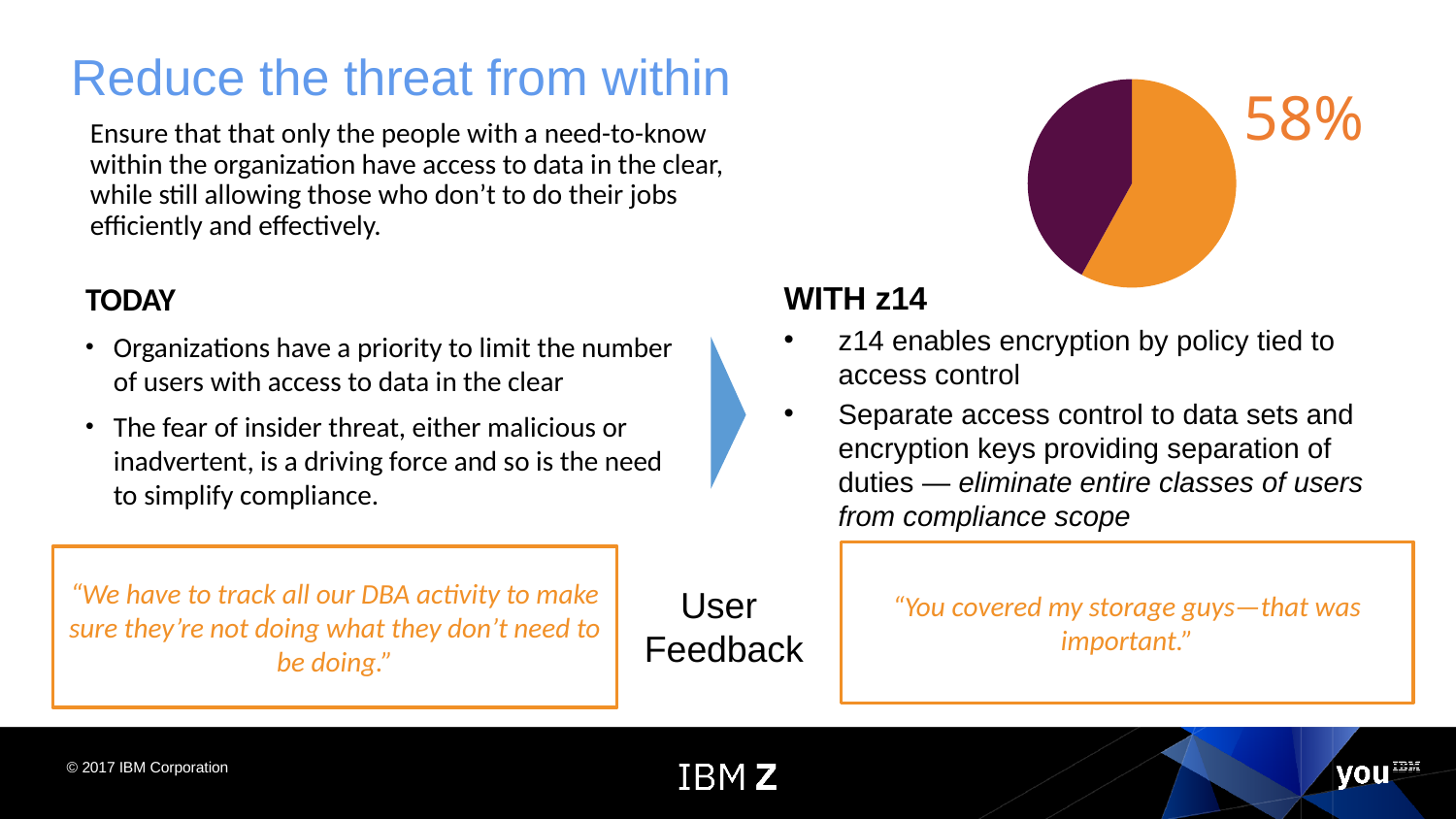
How many slices does the pie chart have? 2 What kind of chart is shown on the slide? pie chart What colour is the smallest slice of the pie chart? purple Does the pie chart show a legend? no Which slice of the pie chart is larger, the orange one or the purple one? orange What colour is the largest slice of the pie chart? orange What percentage is printed next to the orange slice of the pie chart? 58%